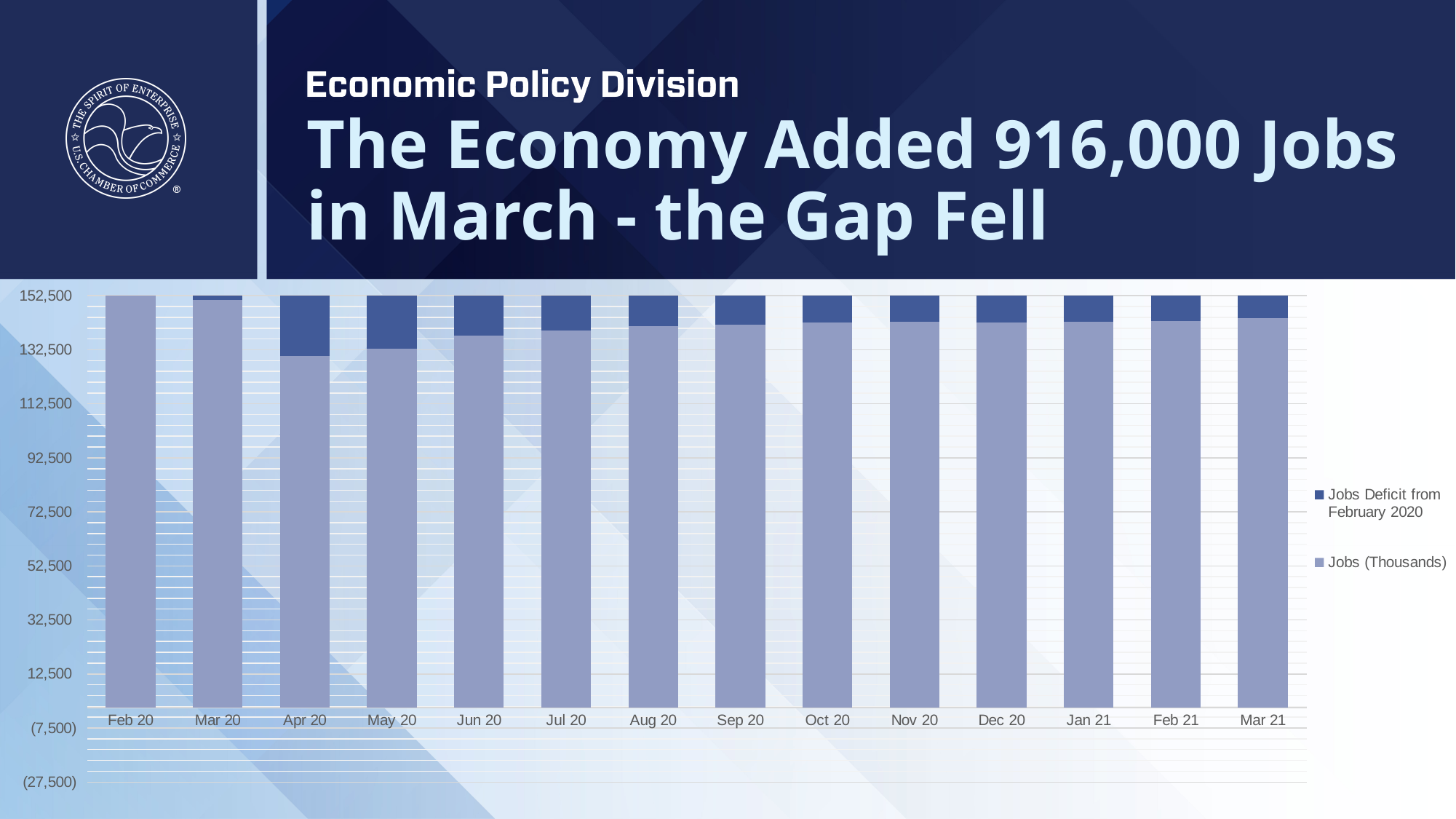
Which month has the lowest value for Jobs (Thousands)? Apr 20 What kind of chart is shown on the slide? Stacked bar chart How many series does the chart legend list? 2 Is the value for Jobs (Thousands) in Jun 20 greater or less than 132,500? greater Which is larger, the Jobs Deficit from February 2020 in May 20 or in Dec 20? May 20 Which month has the highest value for Jobs (Thousands)? Feb 20 Which is larger, Jobs (Thousands) in Jun 20 or in Apr 20? Jun 20 Is the value for Jobs (Thousands) in Apr 20 greater or less than 112,500? greater How many months are shown along the x axis of the chart? 14 Which month has the largest Jobs Deficit from February 2020? Apr 20 From Apr 20 to Mar 21, do the values for Jobs (Thousands) rise or fall? rise What are the two series named in the chart legend? Jobs Deficit from February 2020; Jobs (Thousands)